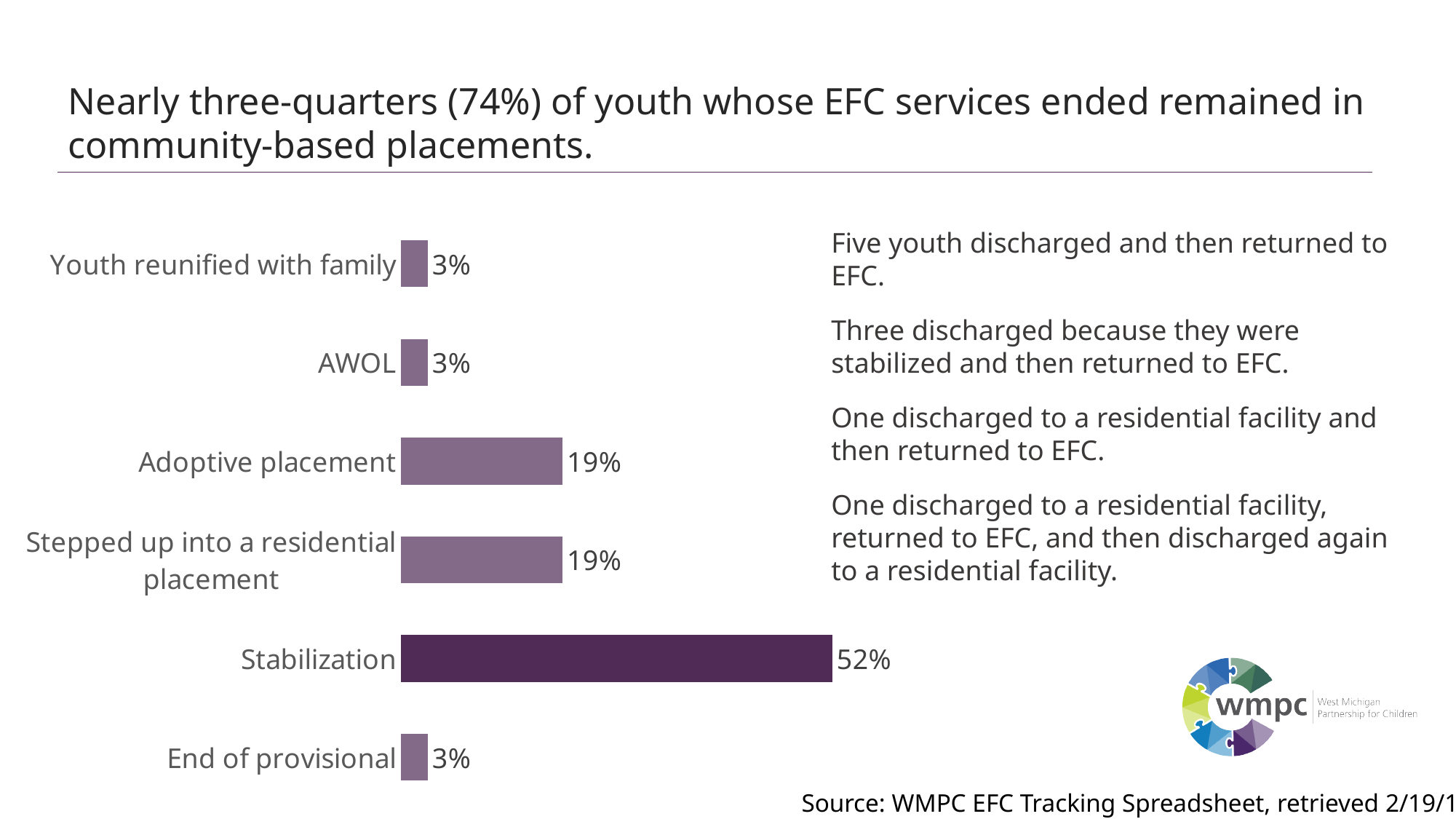
Which bar is shown in a darker colour than the others? Stabilization What is the value for AWOL? 3% Which category has the highest value? Stabilization What is the difference between the values for Stepped up into a residential placement and Youth reunified with family? 16% What kind of chart is shown on the slide? Bar chart What is the value for Stabilization? 52% What is the value for Adoptive placement? 19% What is the value for End of provisional? 3% Which is larger, the value for Stabilization or the value for Stepped up into a residential placement? Stabilization How many categories are shown in the chart? 6 What is the difference between the values for Stabilization and Adoptive placement? 33% Which is larger, the value for Adoptive placement or the value for AWOL? Adoptive placement